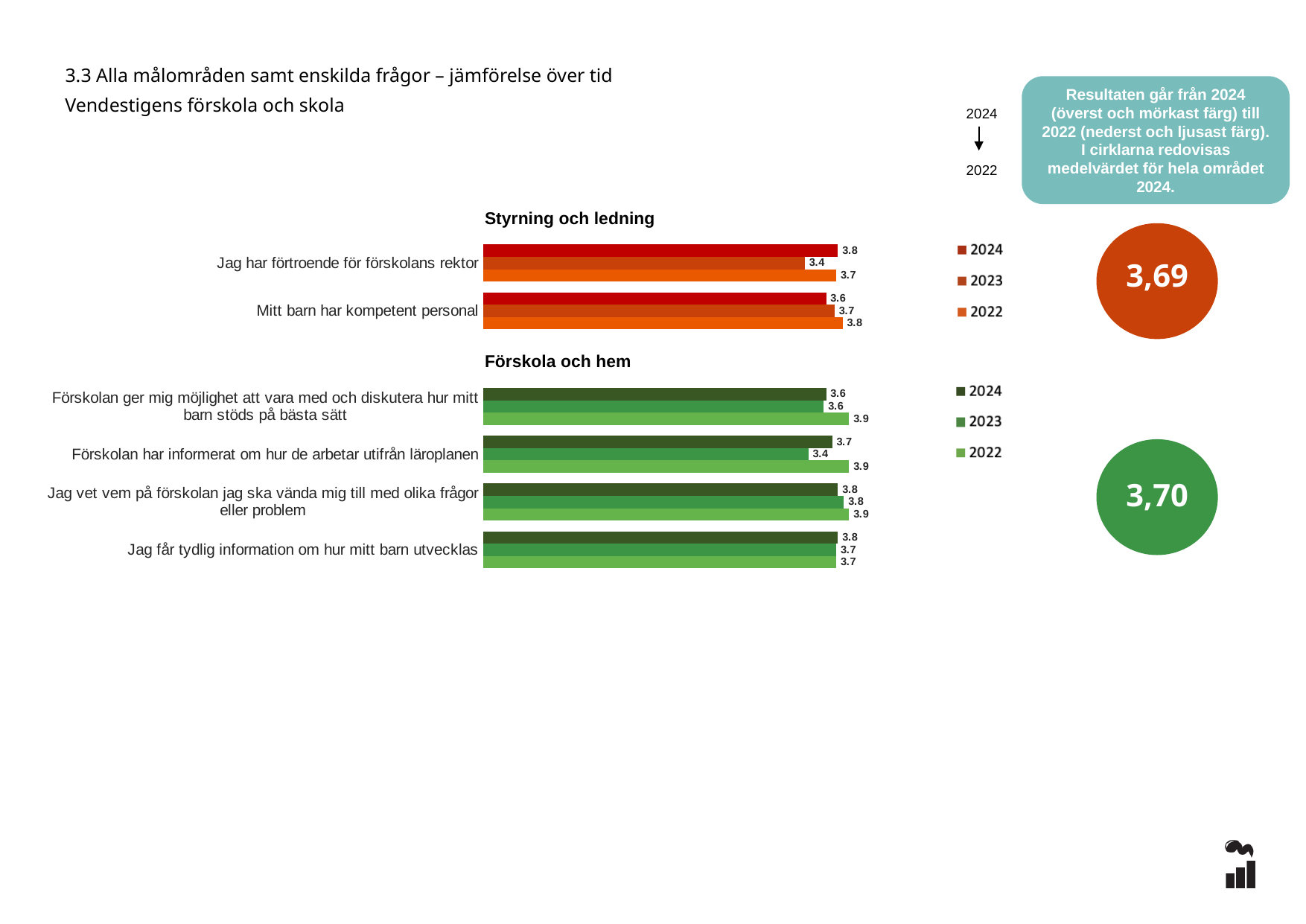
In the 'Förskola och hem' chart, what is the 2022 value for 'Förskolan har informerat om hur de arbetar utifrån läroplanen'? 3.9 In the 'Förskola och hem' chart, which is larger for 'Förskolan ger mig möjlighet att vara med och diskutera hur mitt barn stöds på bästa sätt': the 2024 value or the 2022 value? 2022 In the 'Förskola och hem' chart, what is the 2024 value for 'Jag får tydlig information om hur mitt barn utvecklas'? 3.8 How many series does the legend of the 'Förskola och hem' chart list? 3 In the 'Styrning och ledning' chart, what is the difference between the 2024 and 2023 values for 'Jag har förtroende för förskolans rektor'? 0.4 What kind of chart is the 'Styrning och ledning' chart? Bar chart In the 'Styrning och ledning' chart, what is the 2023 value for 'Jag har förtroende för förskolans rektor'? 3.4 How many categories are shown in the 'Förskola och hem' chart? 4 In the 'Styrning och ledning' chart, what is the 2024 value for 'Jag har förtroende för förskolans rektor'? 3.8 What mean value is shown in the green circle for the 'Förskola och hem' area? 3,70 In the 'Styrning och ledning' chart, what is the 2022 value for 'Mitt barn har kompetent personal'? 3.8 In the 'Förskola och hem' chart, what is the 2023 value for 'Förskolan har informerat om hur de arbetar utifrån läroplanen'? 3.4